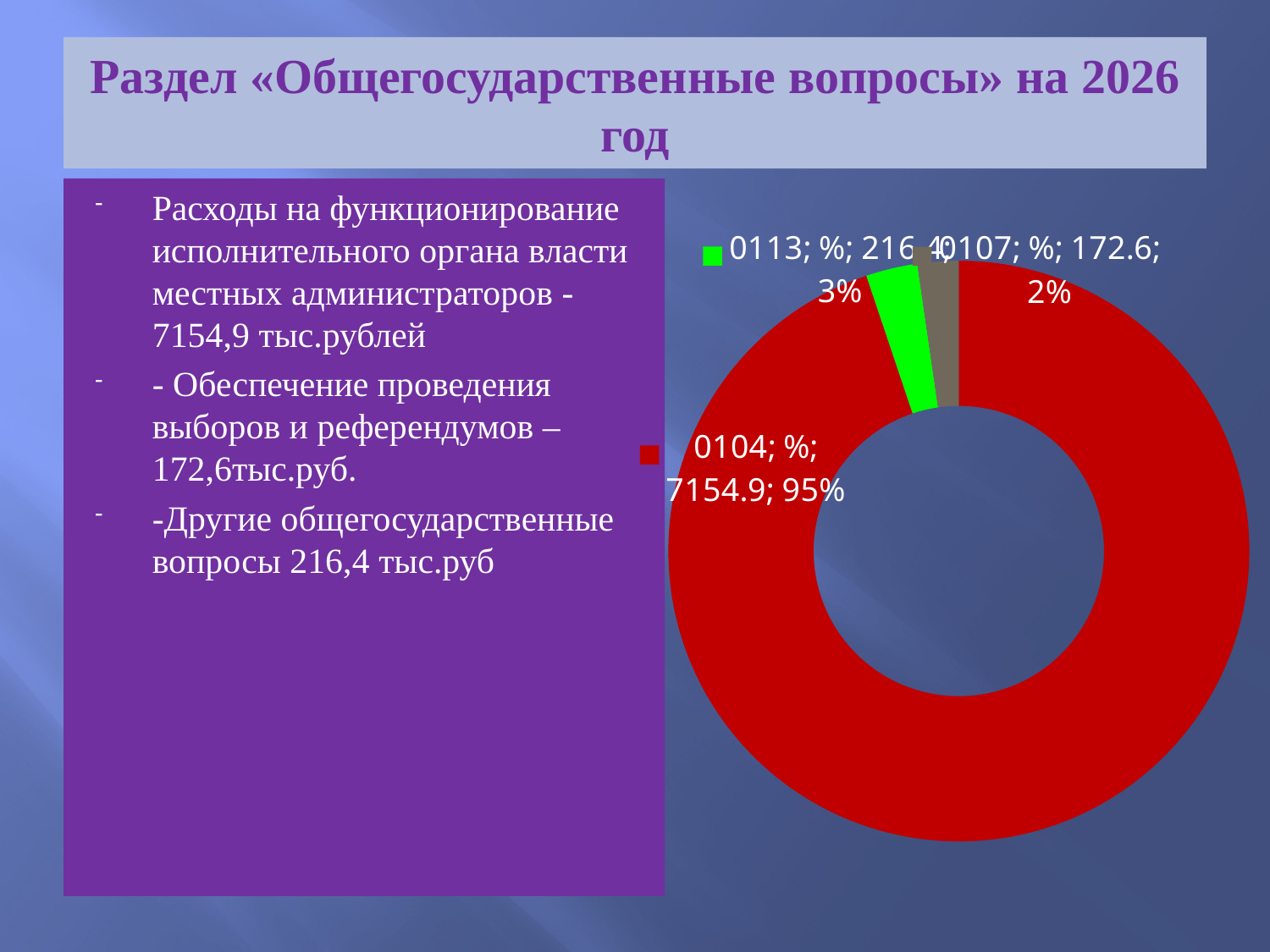
Which slice is larger in the doughnut chart, 0113 or 0107? 0113 Which slice is the largest in the doughnut chart? 0104 What percentage share does slice 0113 have in the doughnut chart? 3% What kind of chart is shown on the slide? doughnut (pie) chart What value is shown for slice 0107 in the doughnut chart? 172.6 What colour is the 0104 slice in the doughnut chart? red What percentage share does slice 0107 have in the doughnut chart? 2% What colour is the 0113 slice in the doughnut chart? green Which slice is the smallest in the doughnut chart? 0107 What value is shown for slice 0104 in the doughnut chart? 7154.9 What percentage share does slice 0104 have in the doughnut chart? 95% How many slices does the doughnut chart have? 3